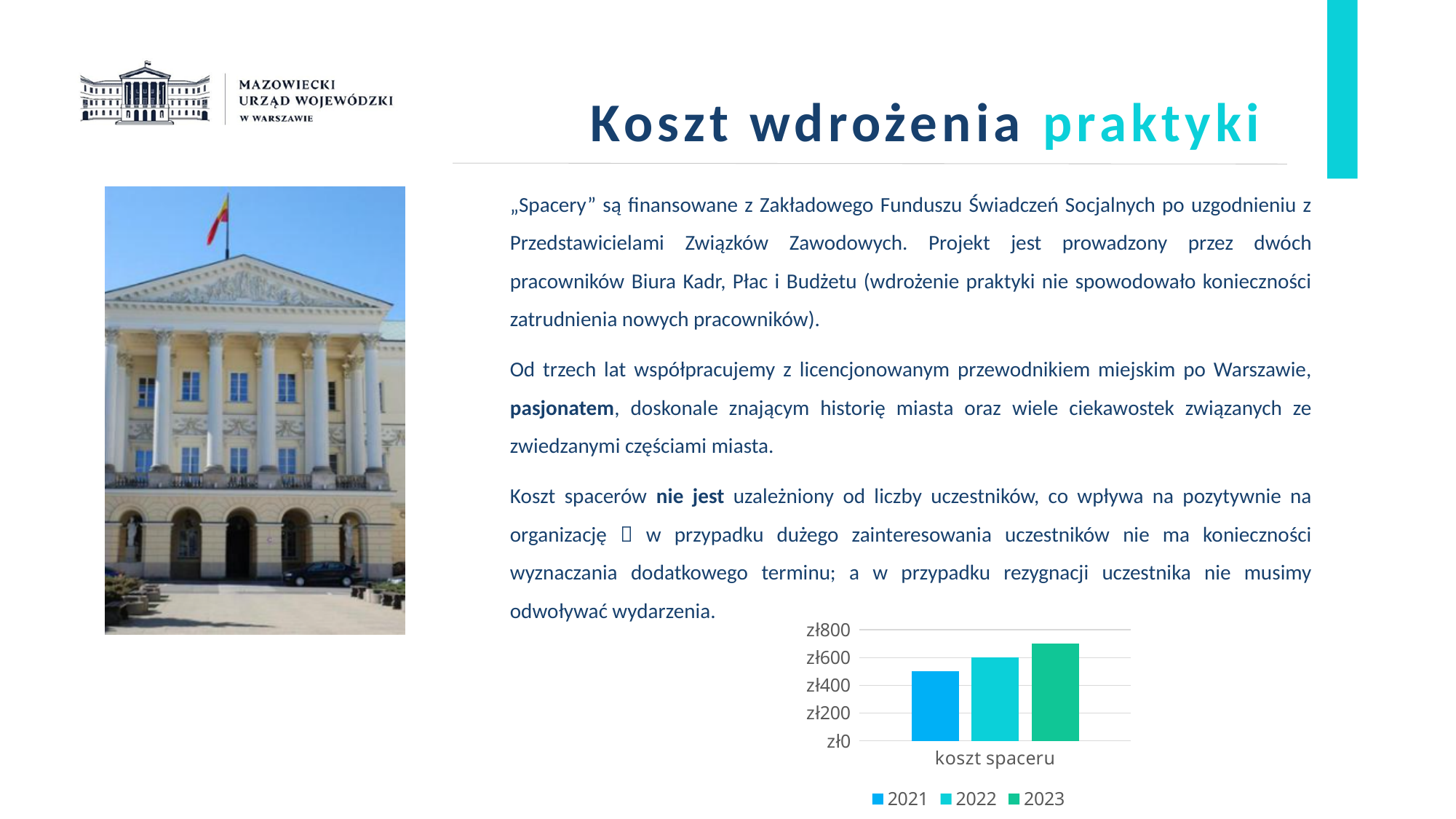
Is the value for 2021 greater or less than zł600? less How many categories are shown on the x axis of the chart? 1 Which is larger, the value for 2021 or the value for 2023? 2023 Do the values rise or fall from 2021 to 2023? rise Is the value for 2023 greater or less than zł800? less What is the category label shown on the x axis of the chart? koszt spaceru What kind of chart is shown on the slide? bar chart Is the value for 2021 greater or less than zł400? greater Which year has the lowest value for koszt spaceru? 2021 How many series does the chart legend list? 3 Which year has the highest value for koszt spaceru? 2023